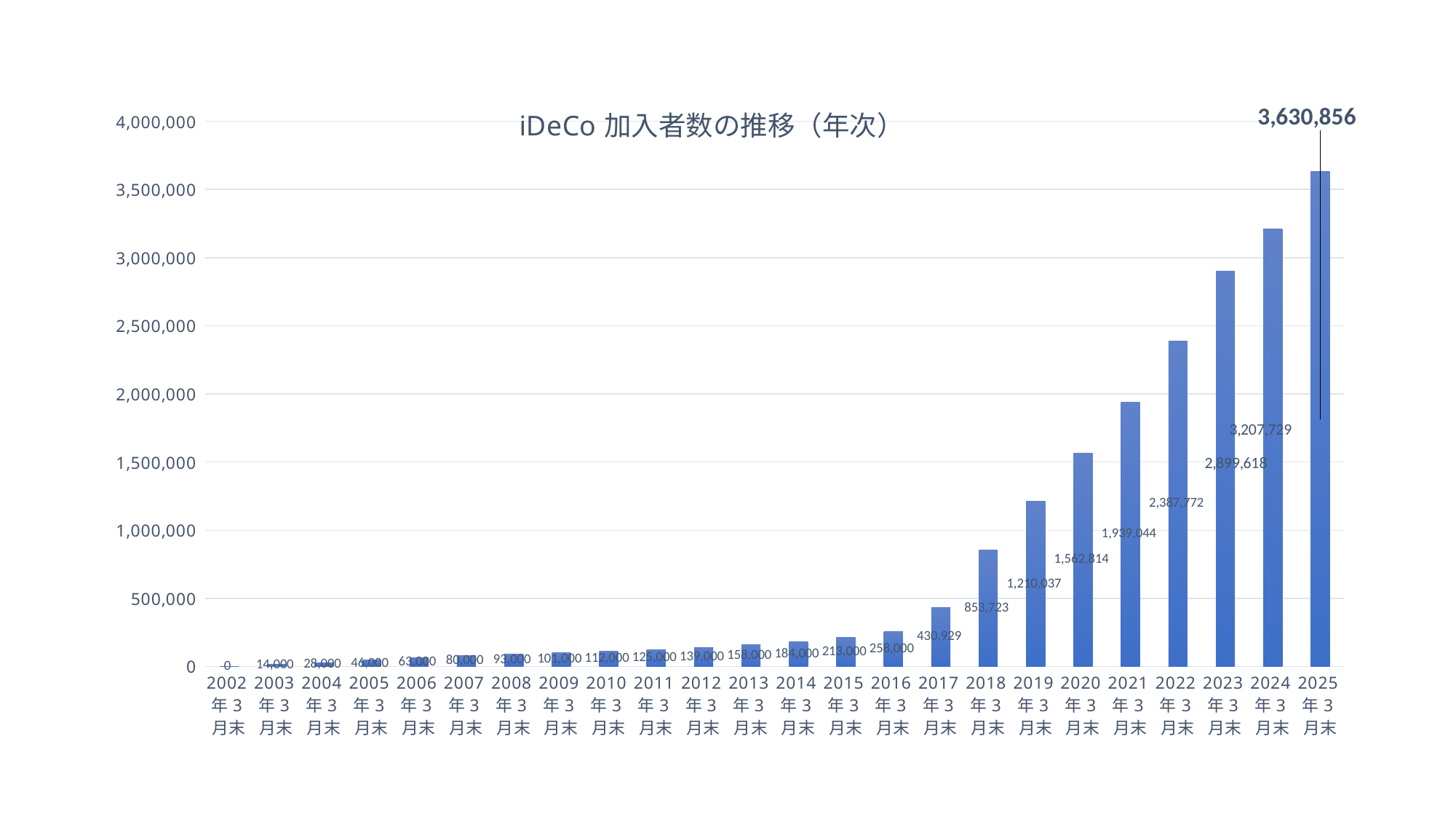
Which year has the lowest value? 2002年3月末 What kind of chart is shown on the slide? bar chart Is the value for 2021年3月末 greater or less than 1,500,000? greater What is the difference between the values for 2025年3月末 and 2024年3月末? 423,127 Which is larger, the value for 2020年3月末 or 2019年3月末? 2020年3月末 What is the value for 2018年3月末? 853,723 Which year has the highest value? 2025年3月末 What is the title of the chart? iDeCo 加入者数の推移（年次） What is the value for 2025年3月末? 3,630,856 What is the value for 2016年3月末? 258,000 How many years are plotted on the x axis? 24 What is the difference between the values for 2023年3月末 and 2022年3月末? 511,846